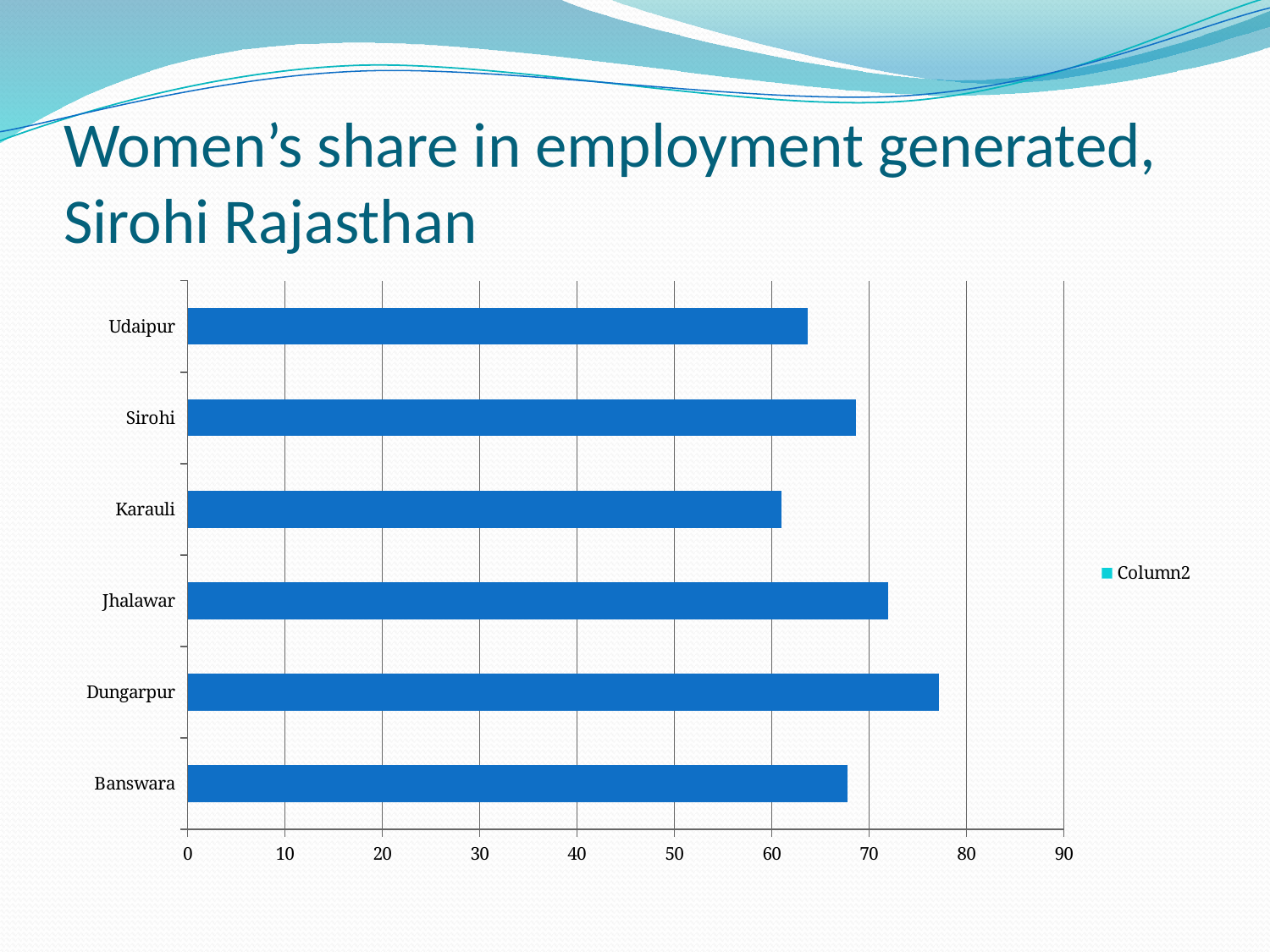
Which is larger, the value for Dungarpur or the value for Udaipur? Dungarpur What is the title of the slide containing the chart? Women's share in employment generated, Sirohi Rajasthan What is the legend entry shown on the chart? Column2 What type of chart is shown on the slide? bar chart Is the value for Jhalawar greater or less than 70? greater Is the value for Dungarpur greater or less than 70? greater Which is larger, the value for Jhalawar or the value for Karauli? Jhalawar How many series does the legend list? 1 How many districts are shown on the chart? 6 Is the value for Udaipur greater or less than 70? less Which district has the highest value on the chart? Dungarpur